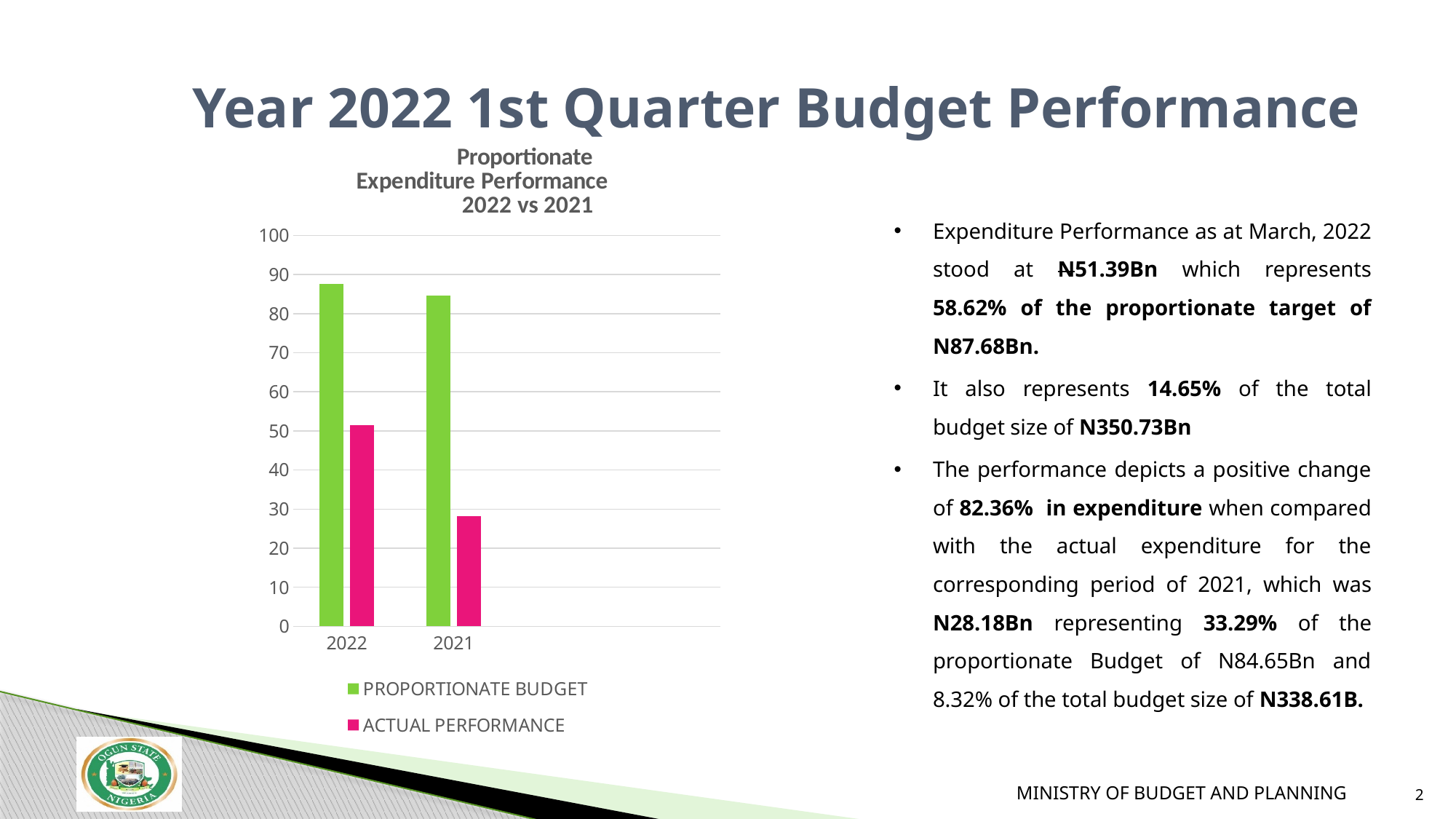
For 2022, which is larger, the PROPORTIONATE BUDGET or the ACTUAL PERFORMANCE? PROPORTIONATE BUDGET Is the ACTUAL PERFORMANCE value for 2022 greater or less than 60? less Which year has the higher ACTUAL PERFORMANCE value, 2022 or 2021? 2022 Is the PROPORTIONATE BUDGET value for 2021 greater or less than 80? greater Which series is shown in green in the chart? PROPORTIONATE BUDGET Is the ACTUAL PERFORMANCE value for 2021 greater or less than 30? less What is the title of the chart? Proportionate Expenditure Performance 2022 vs 2021 How many year categories are shown on the x axis of the chart? 2 What type of chart is shown on the slide? bar chart Which bar in the chart is the lowest? ACTUAL PERFORMANCE for 2021 How many series does the chart legend list? 2